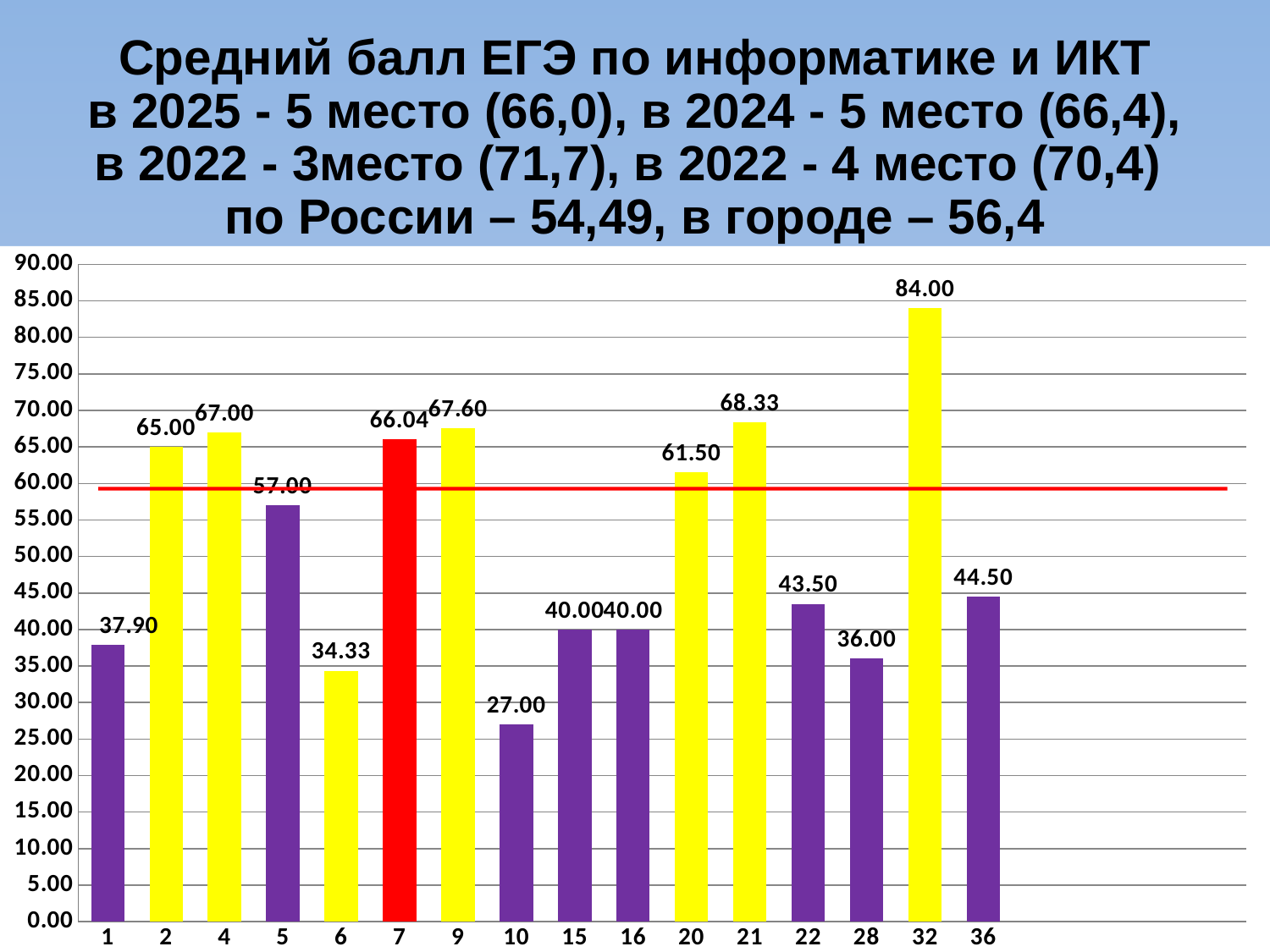
What colour is the bar for category 7? red What is the difference between the values for category 9 and category 2? 2.60 Which category has the lowest value? 10 What is the value for category 10? 27.00 How many categories are shown on the x axis? 16 What is the difference between the values for category 32 and category 21? 15.67 Which category has the highest value? 32 What kind of chart is shown on the slide? bar chart Which is larger, the value for category 5 or the value for category 22? 5 What is the value for category 7? 66.04 Is the value for category 20 greater or less than 60.00? greater What is the value for category 32? 84.00